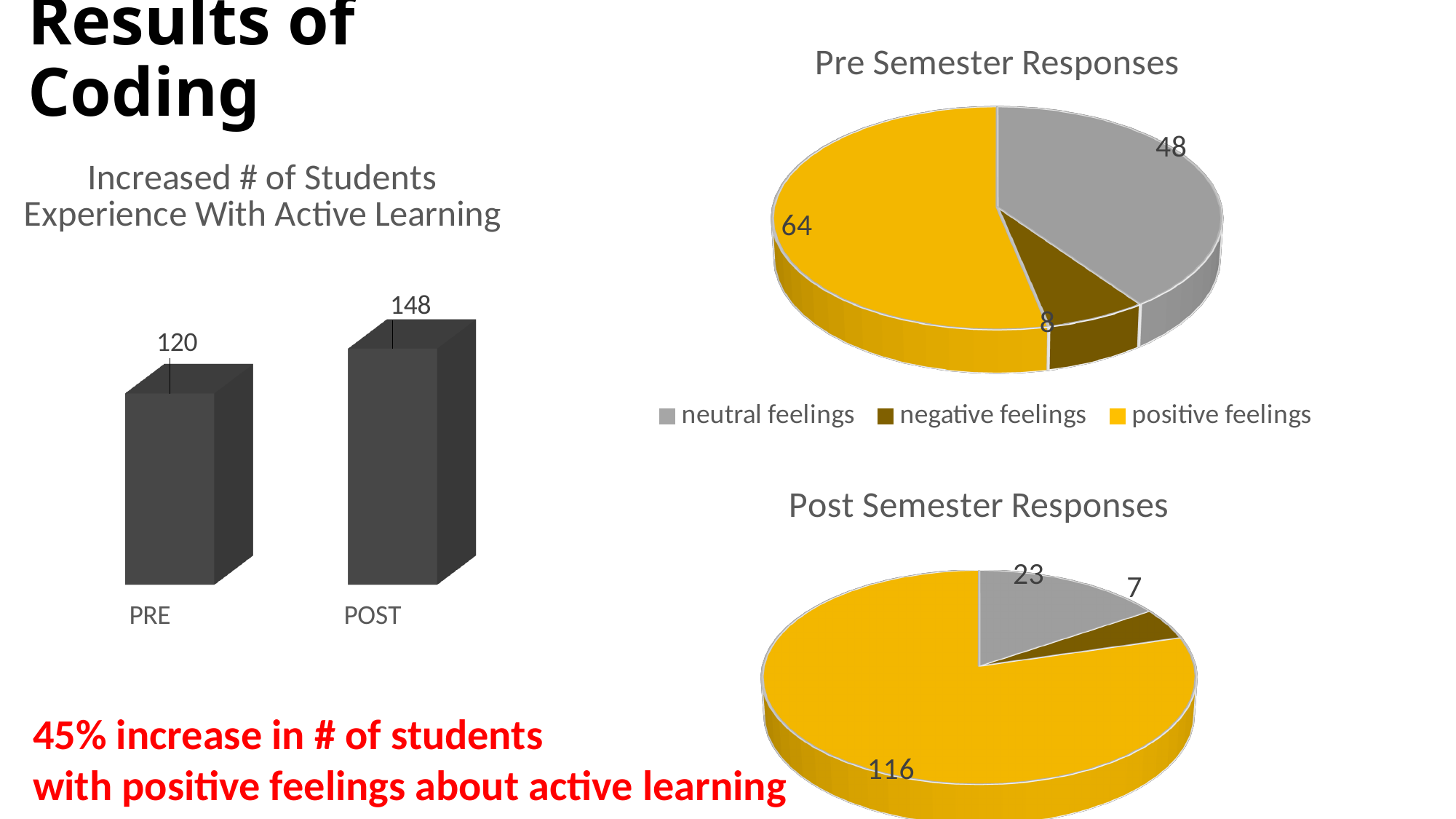
In the 'Increased # of Students Experience With Active Learning' chart, what is the difference between the POST and PRE values? 28 How many categories does the legend for the pie charts list? 3 In the 'Increased # of Students Experience With Active Learning' chart, what is the value for POST? 148 In the 'Post Semester Responses' pie chart, how many responses were neutral feelings? 23 In the 'Increased # of Students Experience With Active Learning' chart, what is the value for PRE? 120 In the 'Pre Semester Responses' pie chart, which category has the smallest slice? negative feelings In the 'Pre Semester Responses' pie chart, what is the difference between positive feelings and neutral feelings? 16 In the 'Post Semester Responses' pie chart, which category has the largest slice? positive feelings In the 'Post Semester Responses' pie chart, what is the total of all three slices? 146 In the 'Pre Semester Responses' pie chart, how many responses were positive feelings? 64 In the 'Pre Semester Responses' pie chart, what share of the total do neutral feelings represent? 40% What kind of chart is 'Increased # of Students Experience With Active Learning'? bar chart